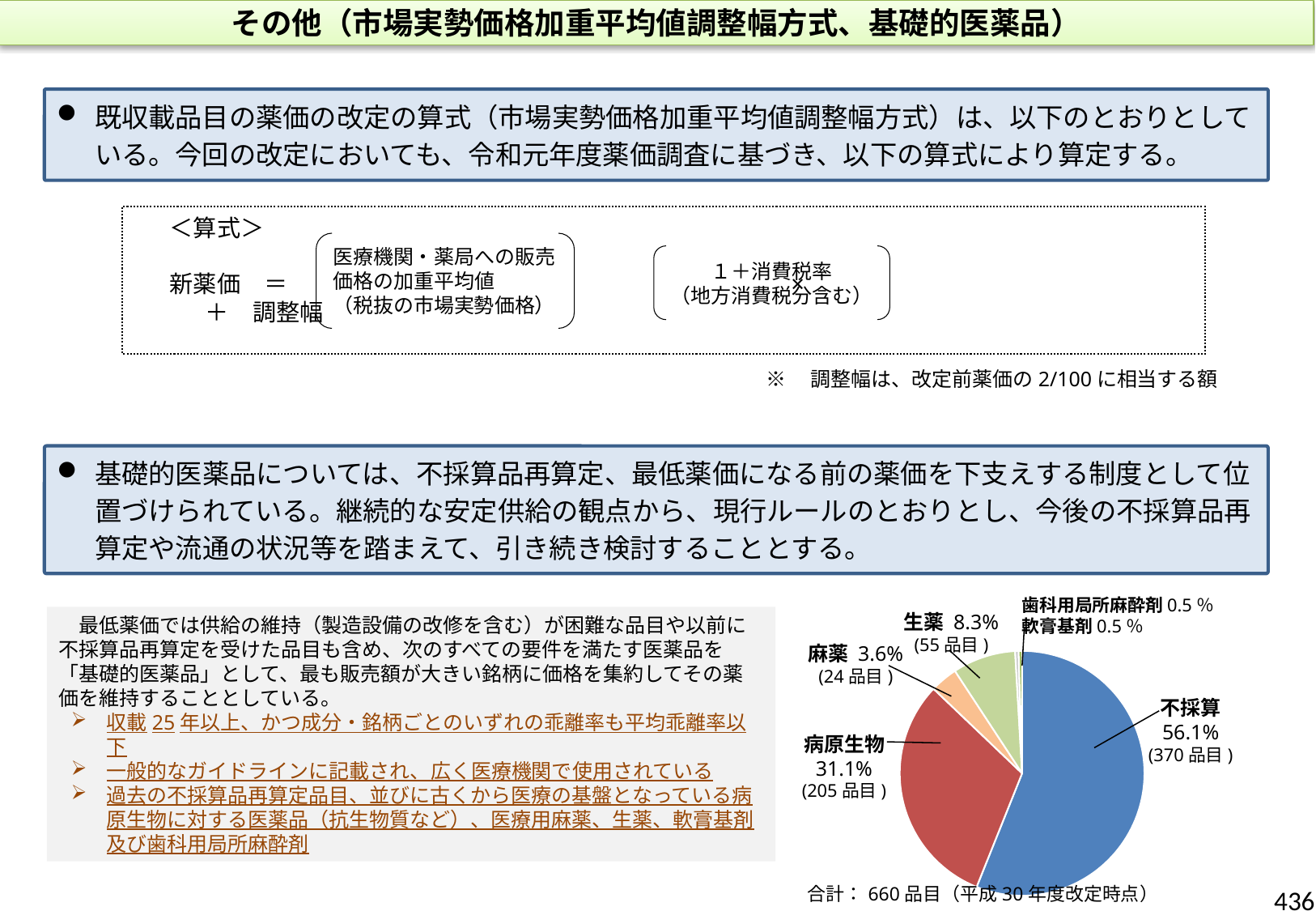
In the pie chart, how many items (品目) are in the 不採算 category? 370 品目 What is the total number of items (合計) stated below the pie chart? 660 品目 Which category has the largest slice in the pie chart? 不採算 What is the difference in share between 不採算 and 病原生物 in the pie chart? 25.0% How many categories are shown in the pie chart? 6 In the pie chart, what share does 不採算 have? 56.1% In the pie chart, what share does 病原生物 have? 31.1% Which is larger in the pie chart, 生薬 or 麻薬? 生薬 What kind of chart is shown at the bottom right of the slide? pie chart In the pie chart, how many items (品目) are in the 病原生物 category? 205 品目 In the pie chart, what share does 生薬 have? 8.3% In the pie chart, what share does 麻薬 have? 3.6%